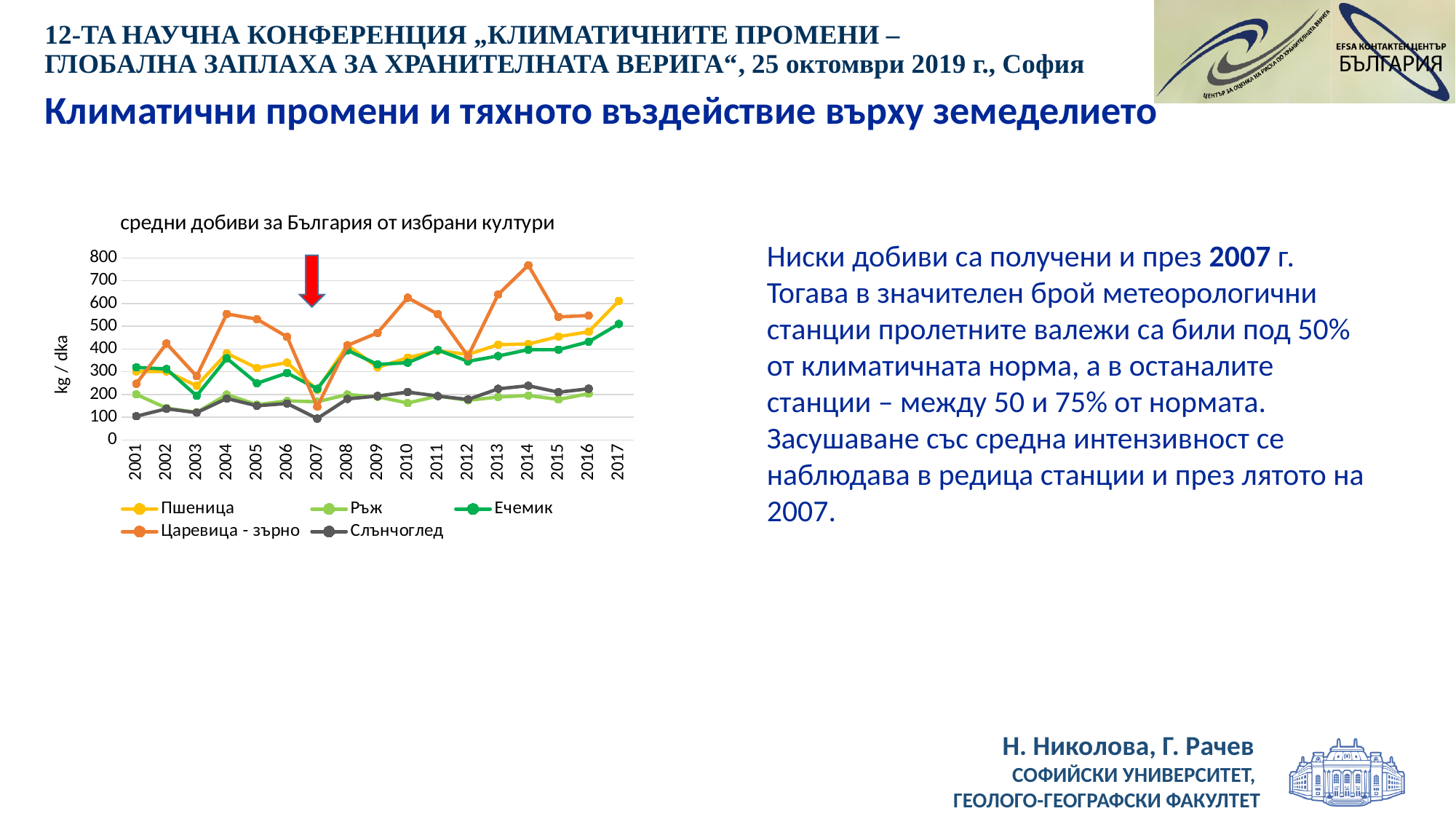
What unit is shown on the y axis of the chart? kg / dka Is the value for Царевица - зърно in 2014 greater or less than 700? greater In 2010, which is larger: the value for Царевица - зърно or the value for Пшеница? Царевица - зърно Is the value for Царевица - зърно in 2007 greater or less than 200? less How many years are plotted along the x axis of the chart? 17 What is the title of the chart? средни добиви за България от избрани култури What kind of chart is shown on the slide? line chart Does the value for Ечемик rise or fall from 2012 to 2017? rise How many series does the legend of the chart list? 5 Which series has the highest value in 2014? Царевица - зърно Which series has the lowest value in 2001? Слънчоглед